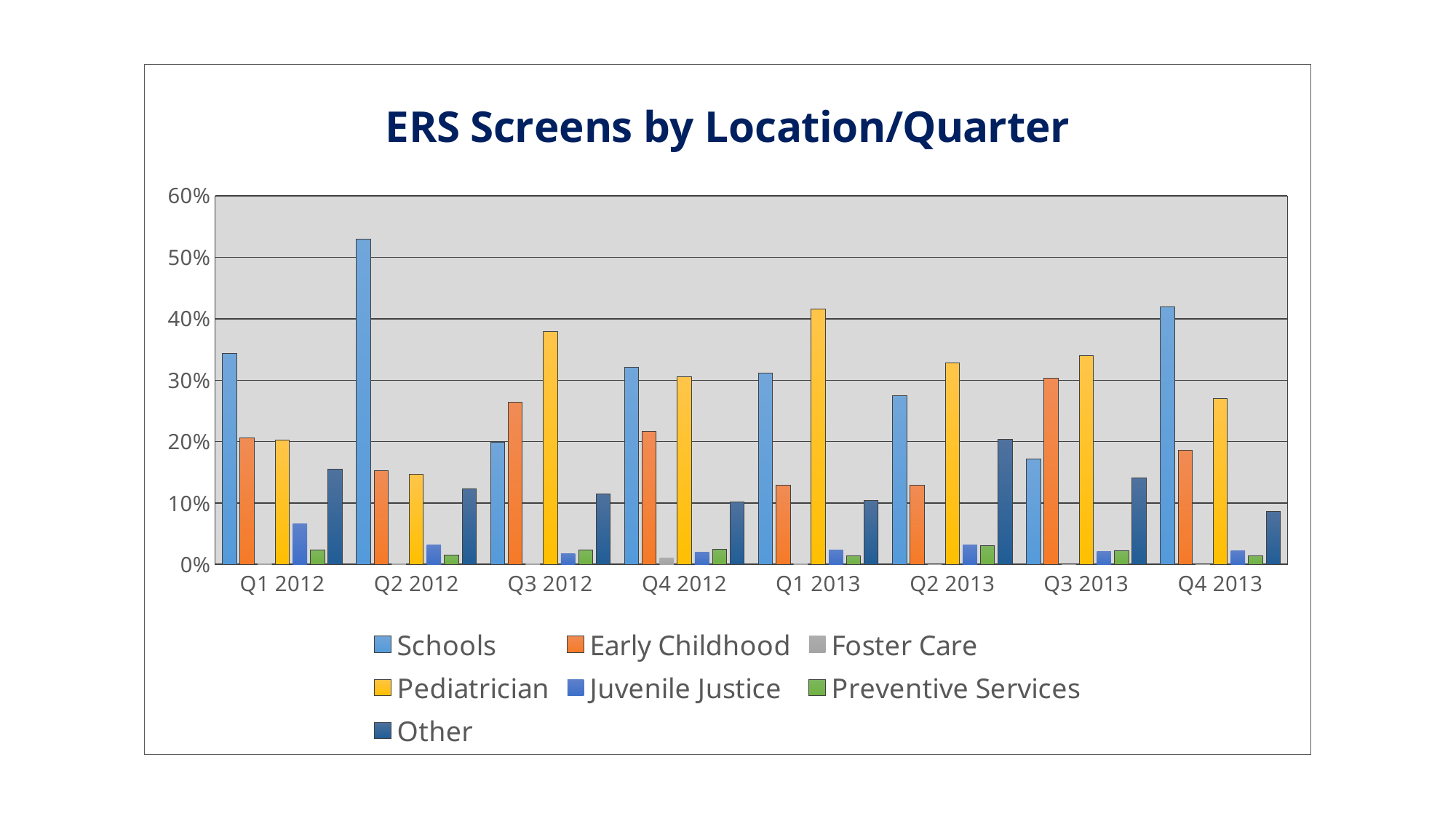
In Q3 2012, which is larger: Pediatrician or Schools? Pediatrician What kind of chart is shown on the slide? bar chart How many quarters are shown on the x axis? 8 Is the Other value for Q4 2013 greater or less than 10%? less In which quarter is the Pediatrician value highest? Q1 2013 How many series does the legend list? 7 In which quarter is the Schools value lowest? Q3 2013 Is the Pediatrician value for Q1 2013 greater or less than 40%? greater Is the Schools value for Q2 2012 greater or less than 50%? greater What is the title of the chart? ERS Screens by Location/Quarter In which quarter is the Schools value highest? Q2 2012 In Q4 2013, which is larger: Schools or Pediatrician? Schools